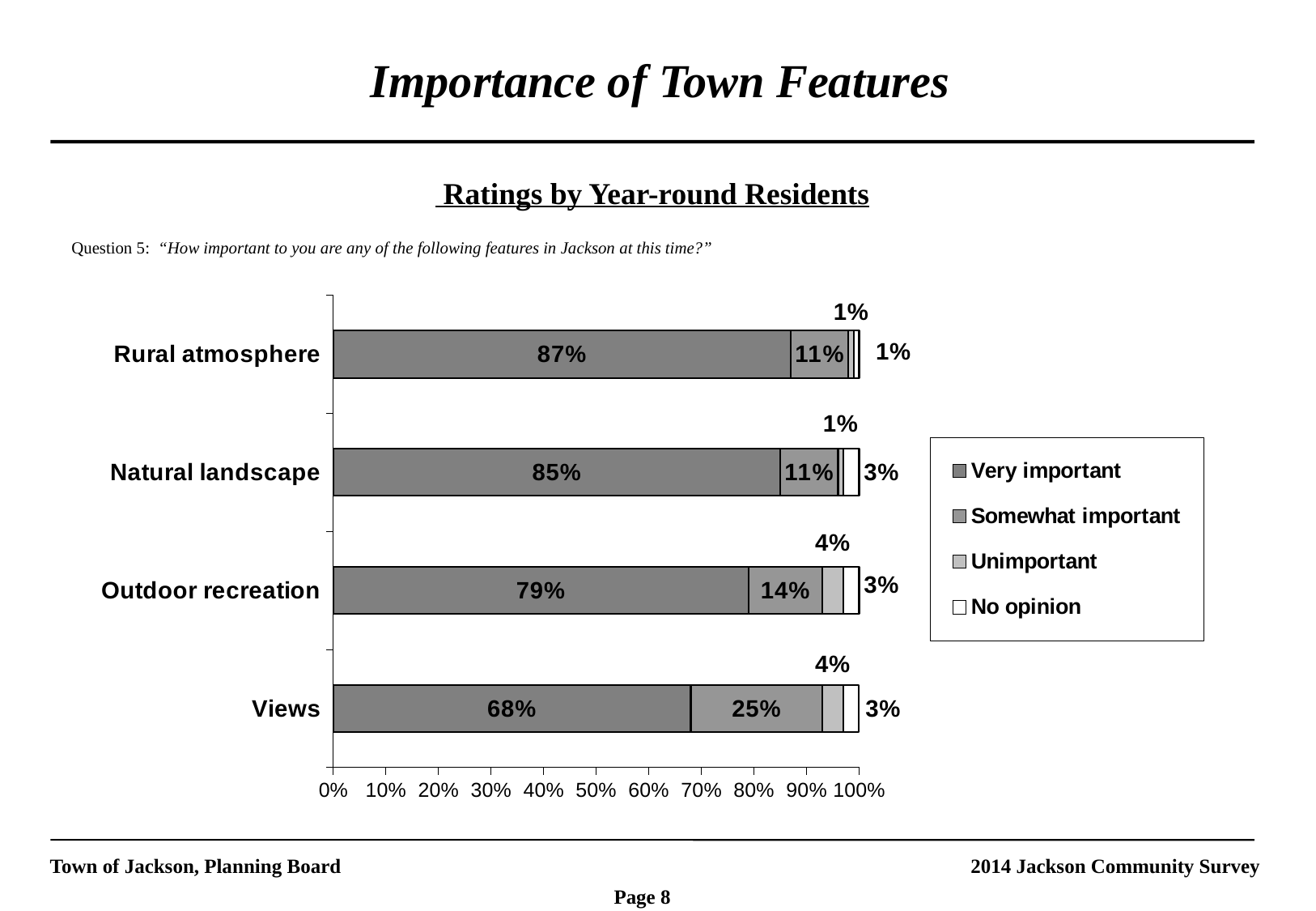
What is the No opinion percentage for Natural landscape? 3% How many series does the legend list? 4 How many town features are shown on the chart? 4 What percentage of year-round residents rated Rural atmosphere as Very important? 87% What type of chart is shown on the slide? Stacked bar chart What percentage of year-round residents rated Views as Somewhat important? 25% Which is larger: the Somewhat important percentage for Outdoor recreation or for Natural landscape? Outdoor recreation What is the difference between the Very important percentages for Rural atmosphere and Views? 19% What is the Unimportant percentage for Outdoor recreation? 4% What is the subtitle shown above the chart? Ratings by Year-round Residents Which feature has the highest Very important percentage? Rural atmosphere Which feature has the lowest Very important percentage? Views